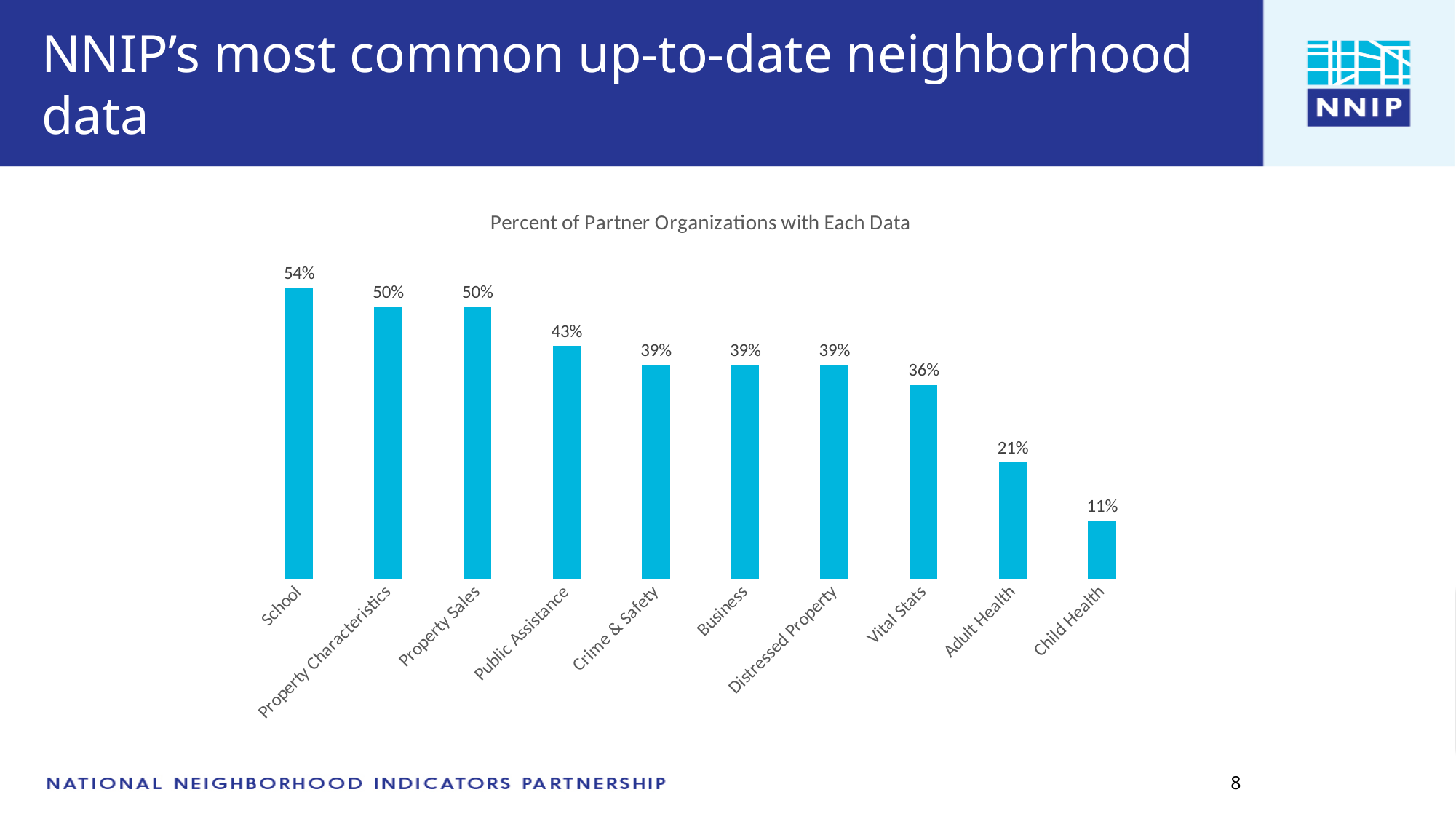
What percent of partner organizations have School data? 54% What kind of chart is shown on the slide? Bar chart What is the title of the chart? Percent of Partner Organizations with Each Data What is the difference between the values for Public Assistance and Vital Stats? 7% Which category has the highest percentage? School How many categories are shown in the chart? 10 Which is larger, the value for Property Sales or the value for Business? Property Sales What is the value for Adult Health? 21% What is the value for Vital Stats? 36% Which category has the lowest percentage? Child Health What is the difference between the values for School and Child Health? 43% What is the value for Public Assistance? 43%